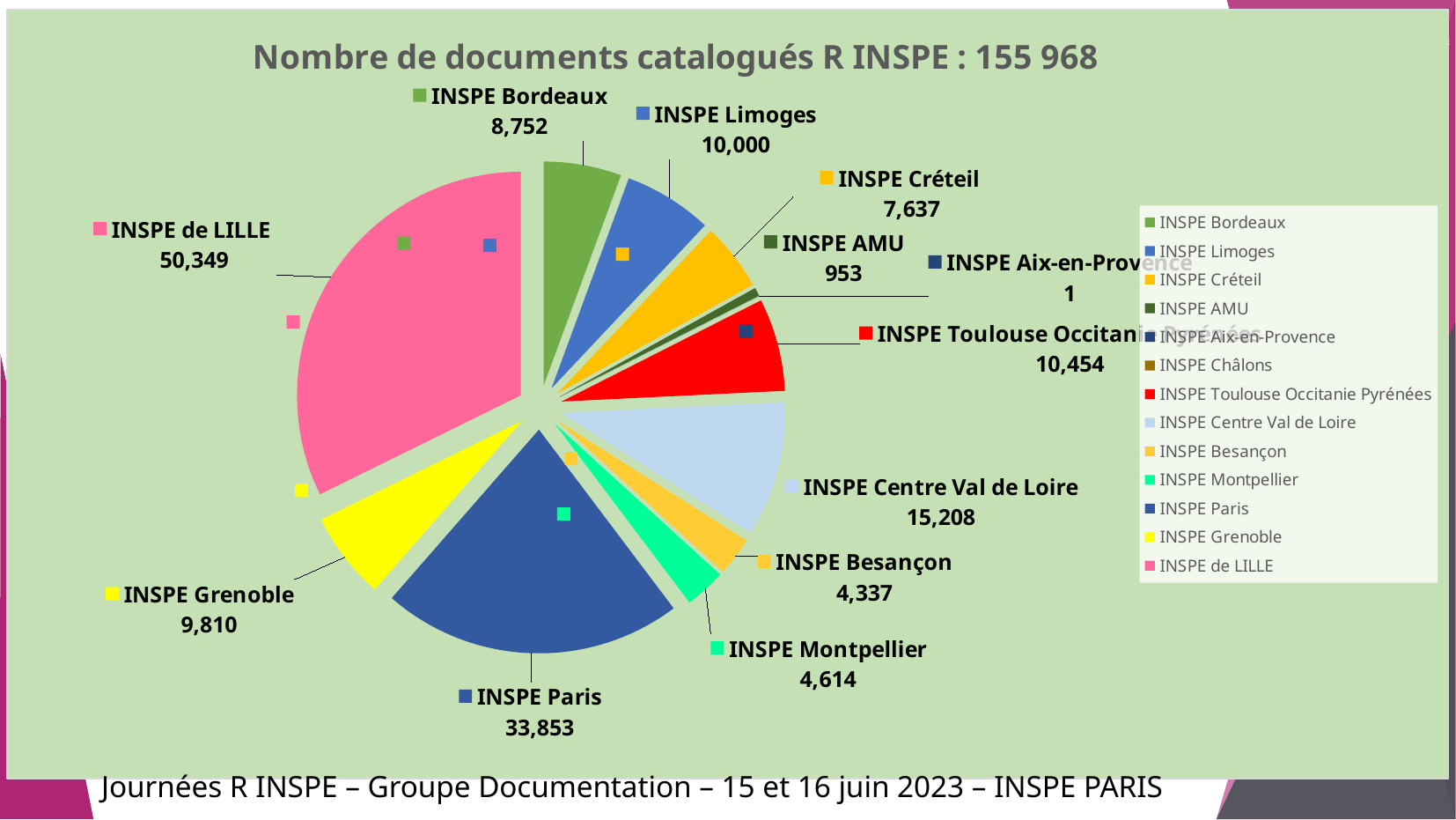
What is the difference between the values for INSPE Montpellier and INSPE Besançon? 277 Which has a larger value, INSPE Limoges or INSPE Bordeaux? INSPE Limoges How many entries does the legend list? 13 Which INSPE has the largest slice of the pie? INSPE de LILLE What is the difference between the values for INSPE de LILLE and INSPE Paris? 16,496 What is the value shown for INSPE Aix-en-Provence? 1 What is the value shown for INSPE Centre Val de Loire? 15,208 How many documents are catalogued for INSPE de LILLE? 50,349 Among the labelled slices, which INSPE has the smallest value? INSPE Aix-en-Provence What is the value shown for INSPE Paris? 33,853 What kind of chart is shown on the slide? pie chart What is the title of the chart? Nombre de documents catalogués R INSPE : 155 968